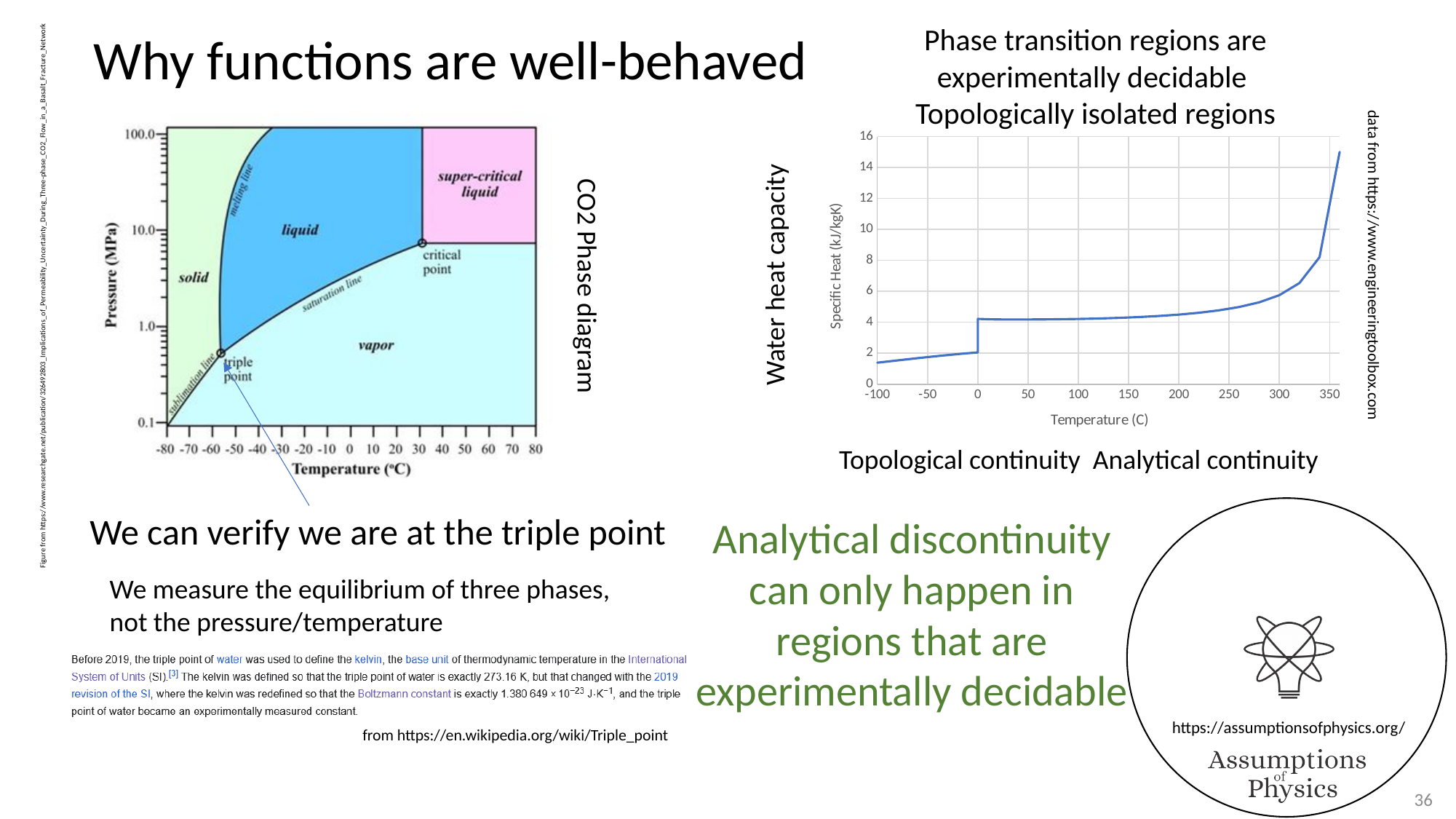
What kind of chart is the 'Water heat capacity' chart on the right? line chart In the 'CO2 Phase diagram', which phase region lies at high temperature and high pressure, above the critical point? super-critical liquid In the 'Water heat capacity' chart, is the specific heat at a temperature of 100 C greater or less than 6? less In the 'Water heat capacity' chart, is the specific heat at a temperature of 200 C greater or less than 4? greater In the 'Water heat capacity' chart, does the specific heat generally rise or fall as temperature increases from -100 C to 350 C? rise In the 'Water heat capacity' chart, what is the label of the y axis? Specific Heat (kJ/kgK) In the 'Water heat capacity' chart, which is larger: the specific heat at 300 C or at 50 C? 300 C In the 'Water heat capacity' chart, at which temperature on the x axis does the specific heat show a sudden jump? 0 In the 'CO2 Phase diagram', is the temperature of the triple point greater or less than 0 °C? less